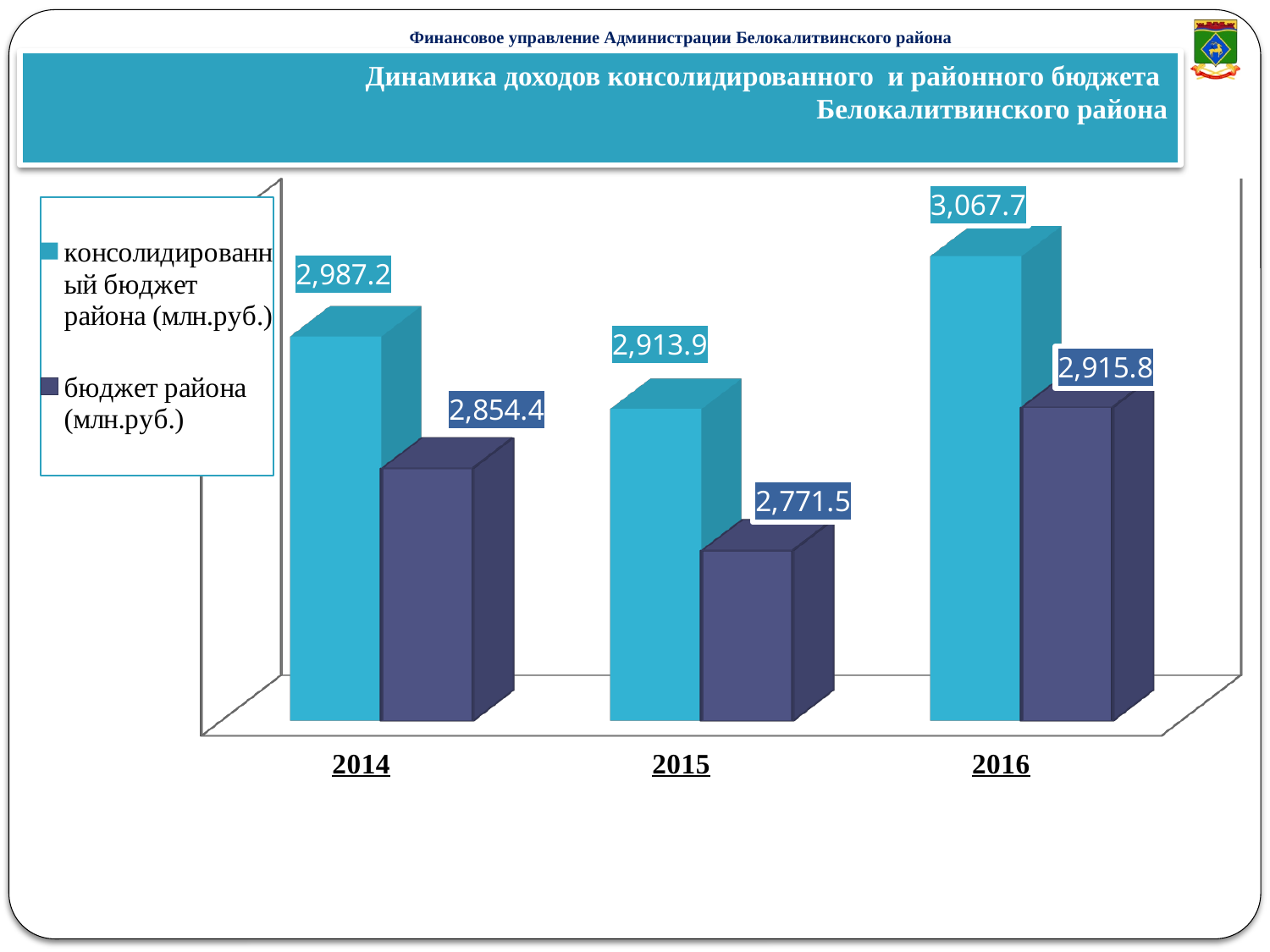
What is the value of the консолидированный бюджет района (млн.руб.) series for 2016? 3,067.7 What is the value of the консолидированный бюджет района (млн.руб.) series for 2014? 2,987.2 What is the difference between the консолидированный бюджет района and the бюджет района values in 2016? 151.9 How many years are shown on the x axis of the chart? 3 What is the value of the бюджет района (млн.руб.) series for 2015? 2,771.5 In which year is the бюджет района (млн.руб.) value the lowest? 2015 What is the value of the бюджет района (млн.руб.) series for 2016? 2,915.8 What is the difference between the консолидированный бюджет района values for 2016 and 2014? 80.5 What kind of chart is shown on the slide? Bar chart Which is larger: the бюджет района value for 2014 or for 2016? 2016 In which year is the консолидированный бюджет района (млн.руб.) value the highest? 2016 How many series does the chart legend list? 2